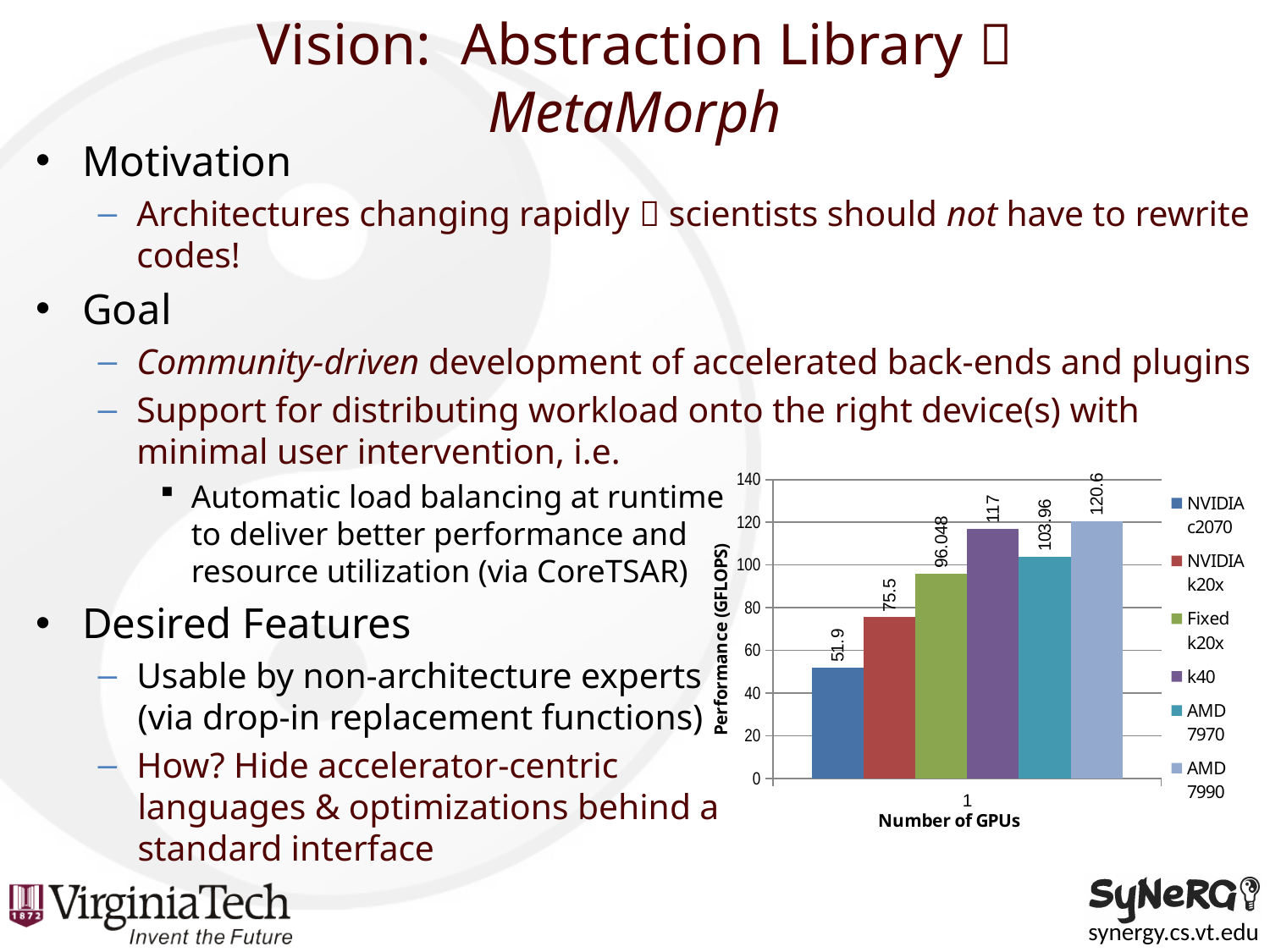
Which is larger, the value for k40 or the value for AMD 7970? k40 What is the performance value for Fixed k20x? 96.048 What type of chart is shown on the slide? bar chart What is the difference between the AMD 7990 value and the NVIDIA k20x value? 45.1 What is the performance value for NVIDIA c2070? 51.9 Is the value for NVIDIA k20x greater or less than 80? less What is the performance value for k40? 117 How many series does the chart legend list? 6 What is the label of the y axis? Performance (GFLOPS) Which series has the lowest performance value? NVIDIA c2070 What is the performance value for AMD 7970? 103.96 Which series has the highest performance value? AMD 7990